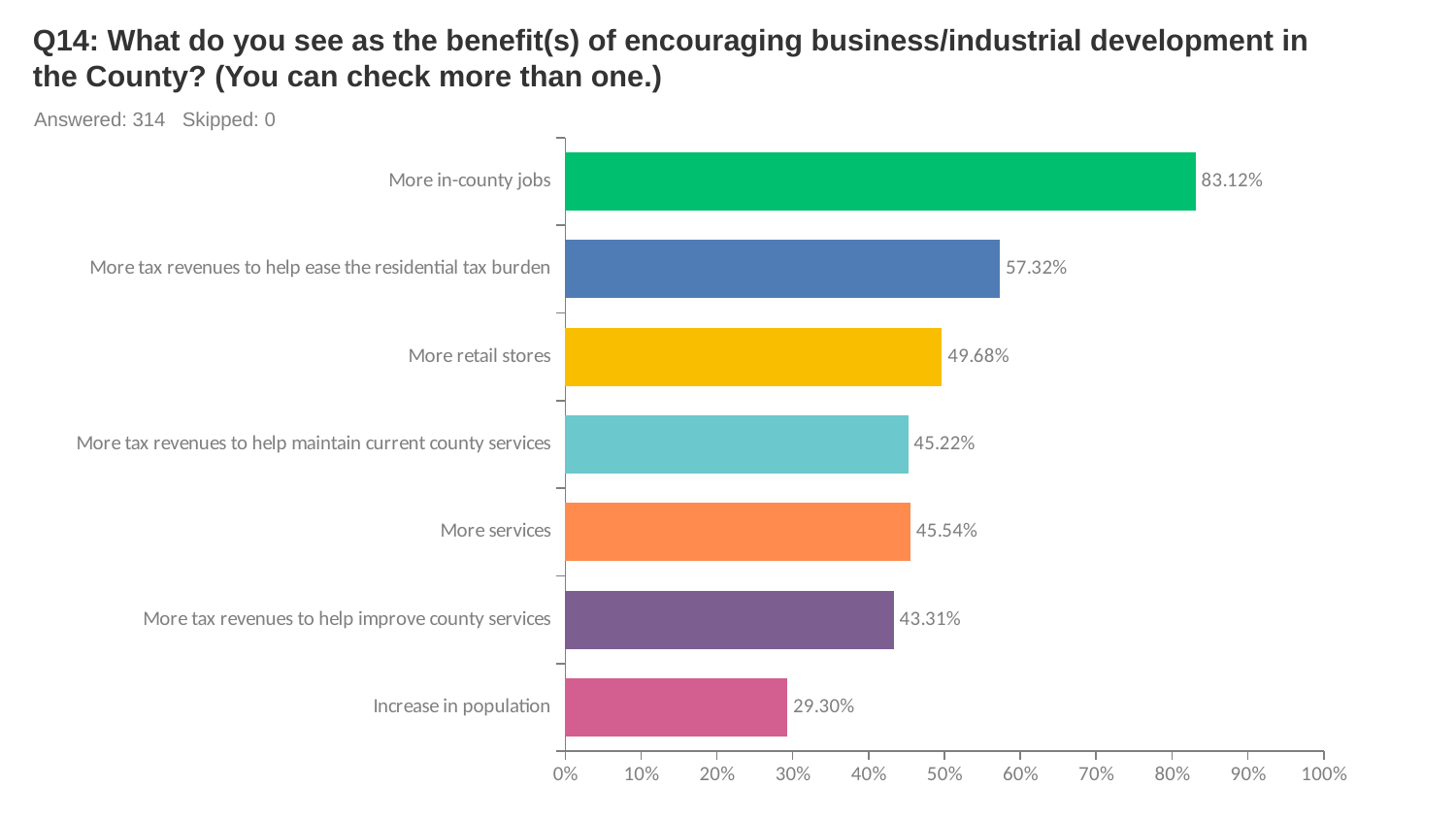
What is the value for "Increase in population"? 29.30% What kind of chart is shown on the slide? Bar chart Which is larger: "More retail stores" or "More services"? More retail stores What is the value for "More tax revenues to help improve county services"? 43.31% How many respondents answered this question? 314 What percentage of respondents selected "More in-county jobs"? 83.12% Which category has the lowest value? Increase in population What percentage is shown for "More retail stores"? 49.68% How many categories are shown in the chart? 7 Is the value for "More tax revenues to help ease the residential tax burden" greater or less than 50%? greater Which category has the highest value? More in-county jobs What is the difference between "More in-county jobs" and "More tax revenues to help ease the residential tax burden"? 25.80%